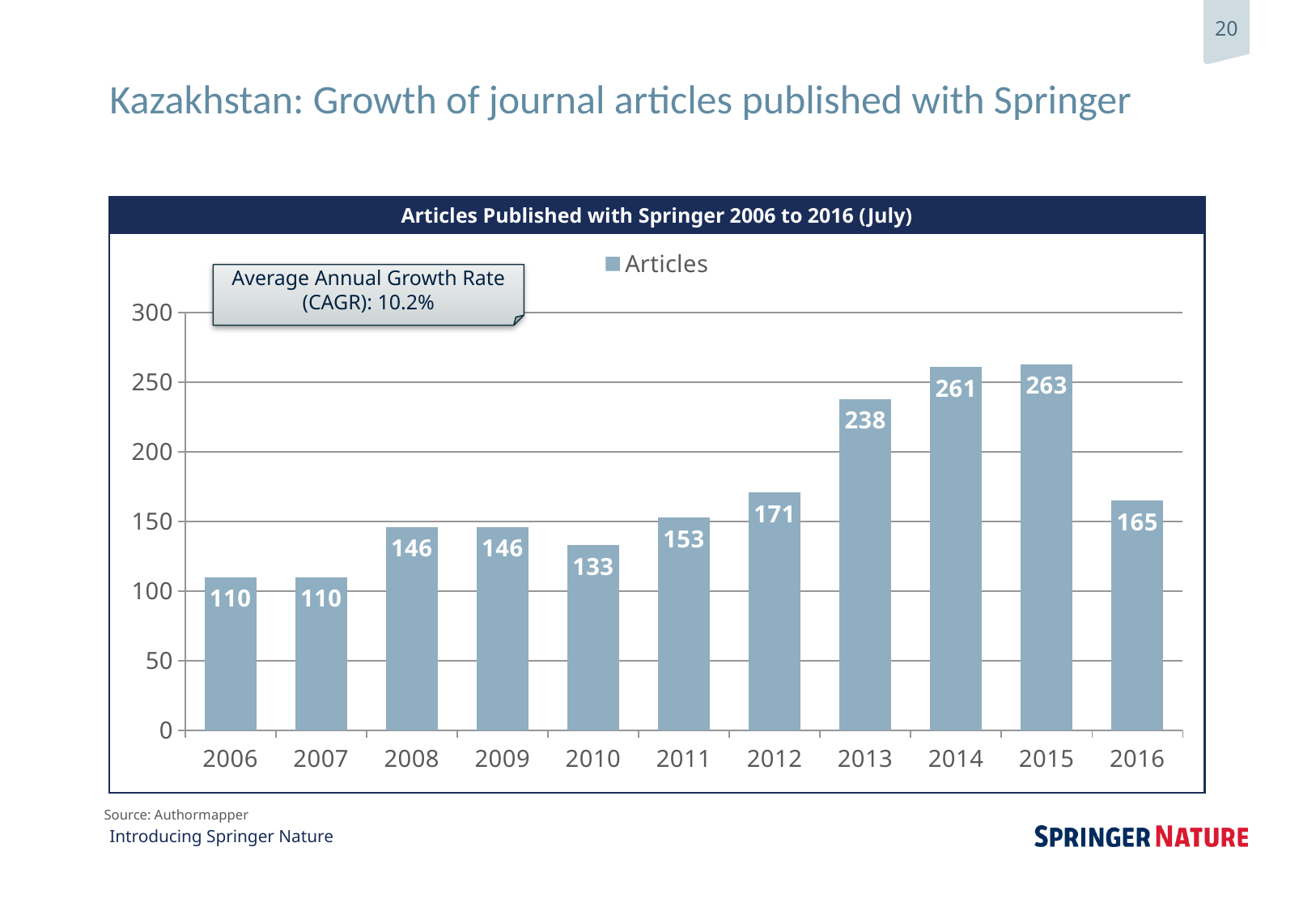
What is the difference between the values for 2013 and 2012? 67 What is the Average Annual Growth Rate (CAGR) stated on the chart? 10.2% How many years are shown on the x axis? 11 Which is larger, the value for 2011 or the value for 2016? 2016 What is the difference between the values for 2015 and 2006? 153 Which year has the highest number of articles? 2015 How many articles were published with Springer in 2013? 238 Which years have the lowest number of articles? 2006 and 2007 What kind of chart is shown? Bar chart What is the value for 2010? 133 How many series does the legend list? 1 Is the value for 2014 greater or less than 250? greater